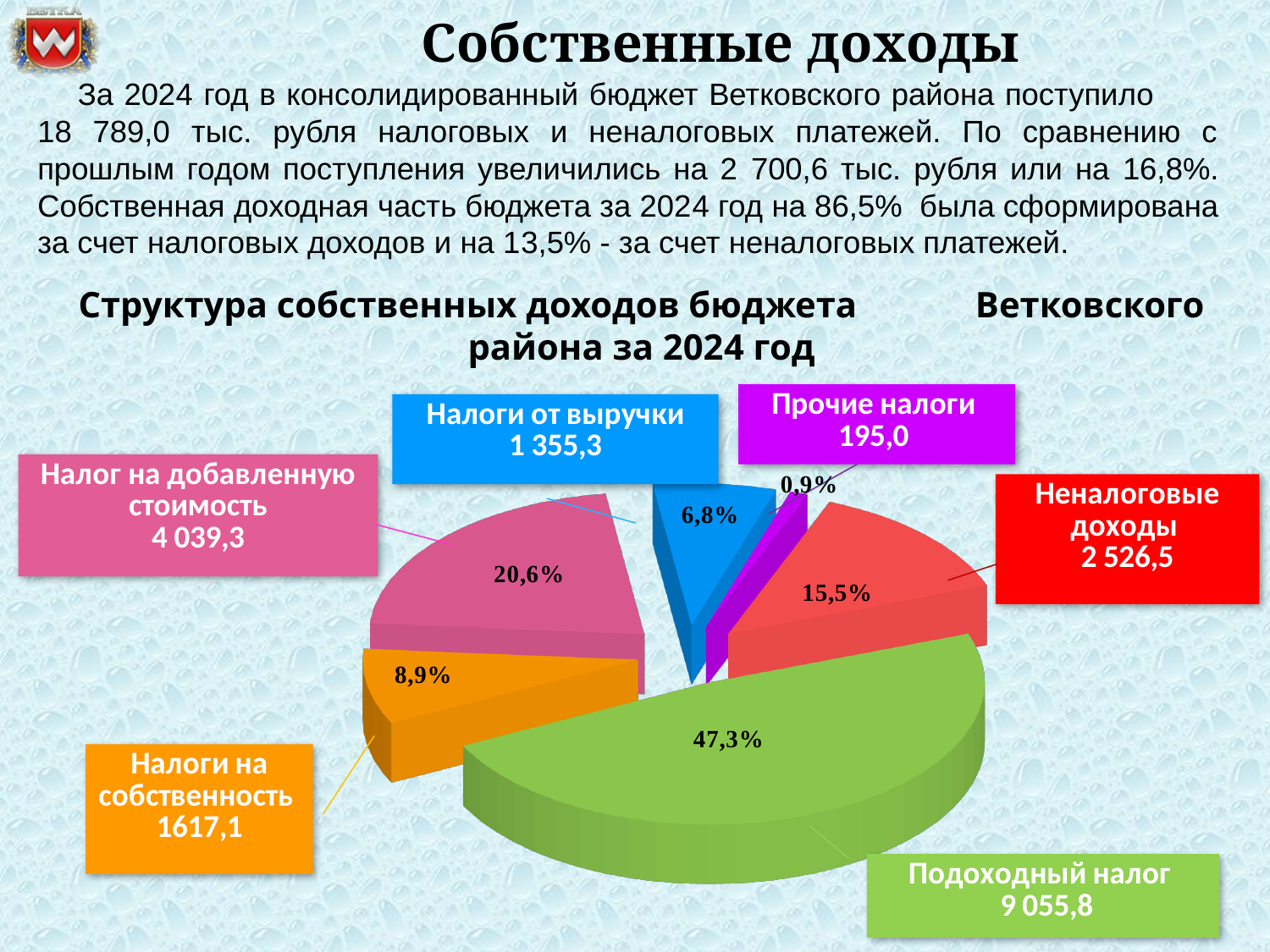
Какая категория имеет наибольшую долю в структуре собственных доходов? Подоходный налог Какую долю занимают прочие налоги? 0,9% Какую долю в структуре собственных доходов занимает подоходный налог? 47,3% Какая сумма указана для налогов от выручки? 1 355,3 Какая сумма указана для налога на добавленную стоимость? 4 039,3 Сколько категорий показано на круговой диаграмме? 6 Какая категория имеет наименьшую долю в структуре собственных доходов? Прочие налоги На сколько процентных пунктов доля налога на добавленную стоимость больше доли неналоговых доходов? 5,1 Каким цветом на диаграмме показан подоходный налог? Зелёным Что больше: доля налогов от выручки или доля налогов на собственность? Налоги на собственность Какой тип диаграммы показан на слайде? Круговая диаграмма Какая сумма указана для неналоговых доходов? 2 526,5